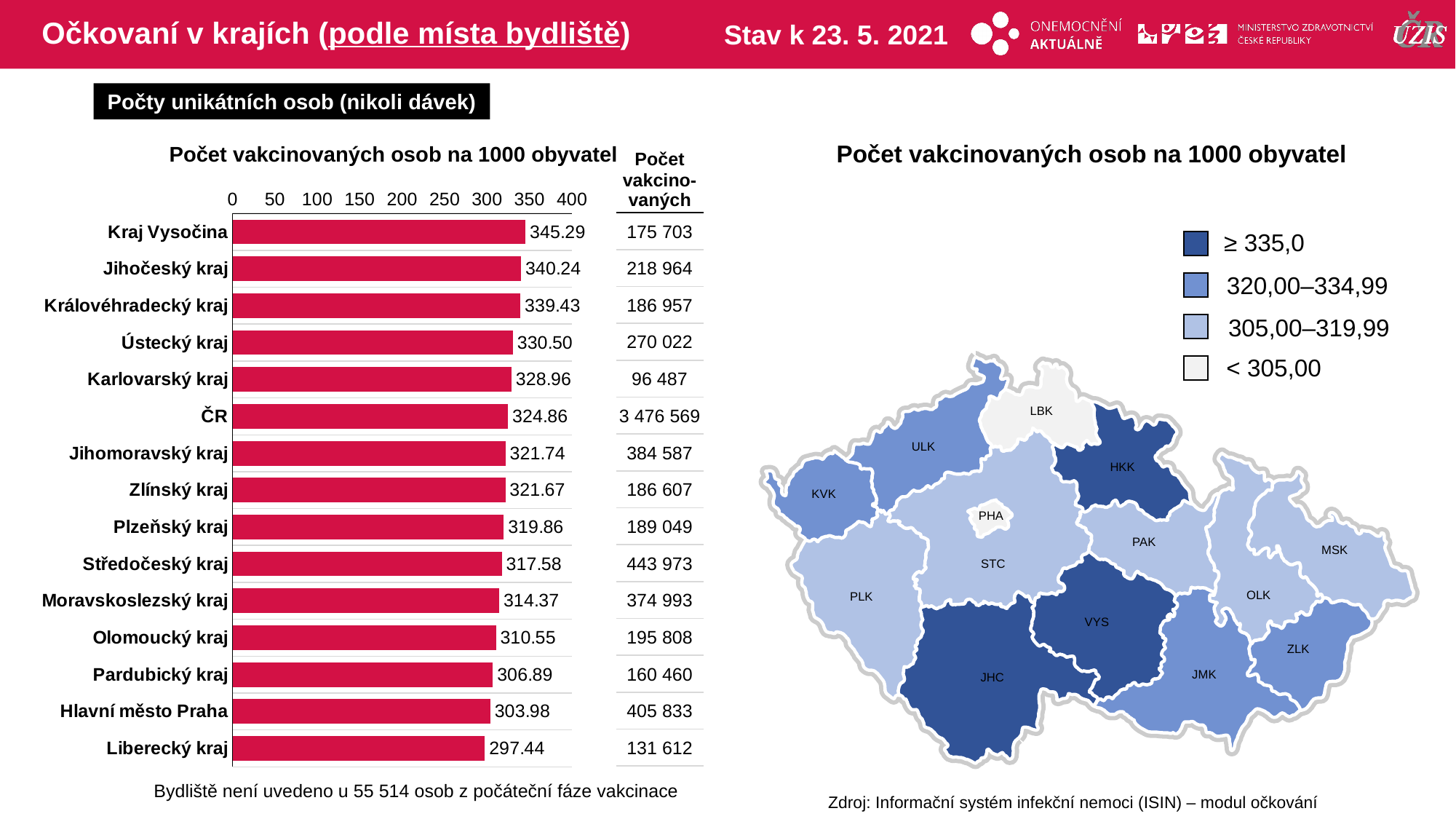
In the table column 'Počet vakcinovaných' next to the bar chart, what is the value for Středočeský kraj? 443 973 In the bar chart 'Počet vakcinovaných osob na 1000 obyvatel', is the value for Olomoucký kraj greater or less than 300? greater In the bar chart 'Počet vakcinovaných osob na 1000 obyvatel', what is the difference between Kraj Vysočina and Liberecký kraj? 47.85 In the map legend on the right, what is the range shown for the second-darkest blue shade? 320,00–334,99 In the bar chart 'Počet vakcinovaných osob na 1000 obyvatel', which region has the lowest value? Liberecký kraj In the bar chart 'Počet vakcinovaných osob na 1000 obyvatel', what is the value for Hlavní město Praha? 303.98 In the bar chart 'Počet vakcinovaných osob na 1000 obyvatel', what is the value for Kraj Vysočina? 345.29 What kind of chart is used on the left side of the slide to show 'Počet vakcinovaných osob na 1000 obyvatel'? bar chart In the bar chart 'Počet vakcinovaných osob na 1000 obyvatel', which is larger: Ústecký kraj or Karlovarský kraj? Ústecký kraj In the bar chart 'Počet vakcinovaných osob na 1000 obyvatel', what is the value for ČR? 324.86 In the bar chart 'Počet vakcinovaných osob na 1000 obyvatel', which region has the highest value? Kraj Vysočina How many bars are shown in the bar chart 'Počet vakcinovaných osob na 1000 obyvatel'? 15